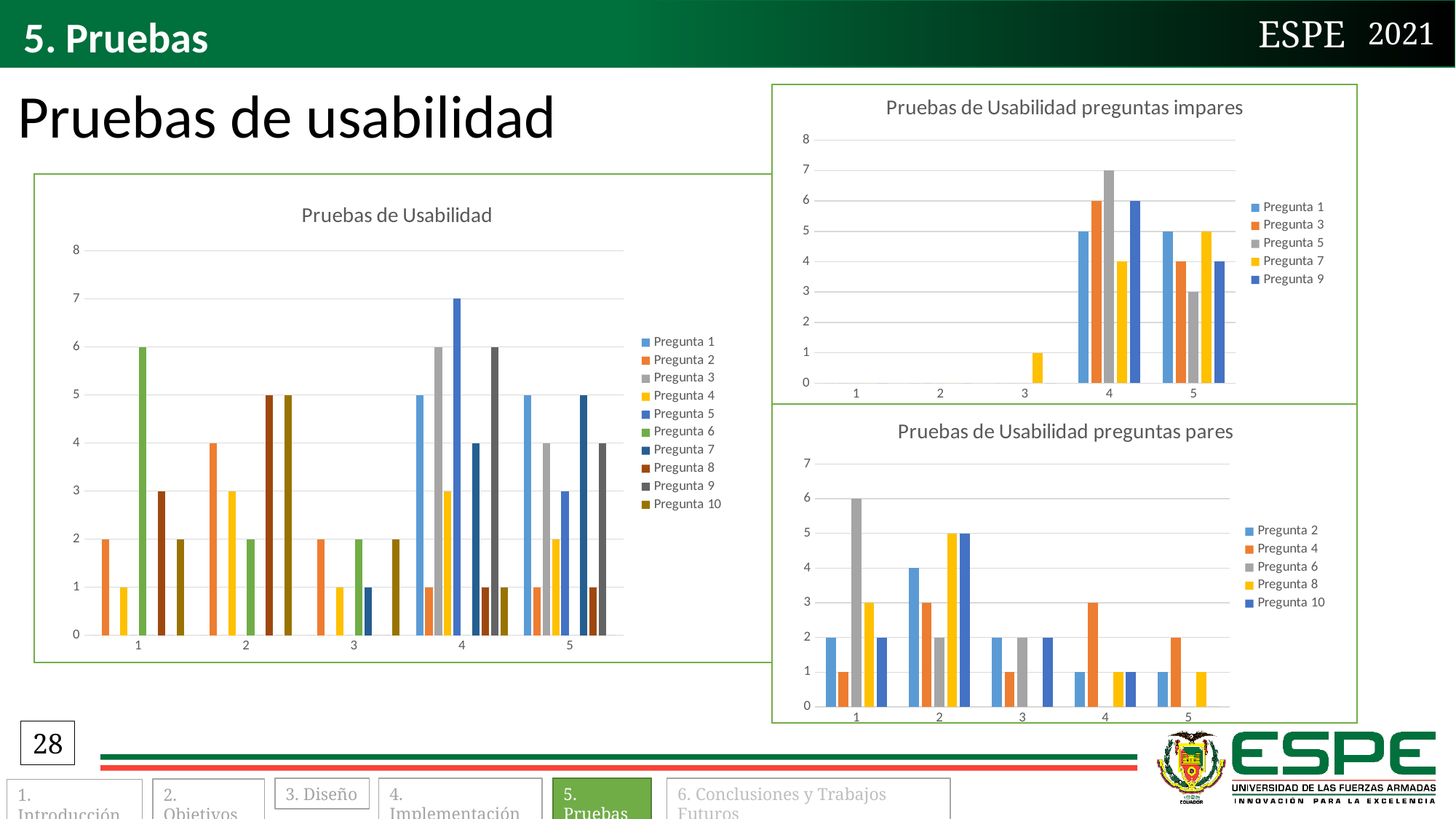
What kind of chart is the chart titled 'Pruebas de Usabilidad preguntas pares'? bar chart In the chart titled 'Pruebas de Usabilidad preguntas pares', is the value of Pregunta 4 at category 4 larger than the value of Pregunta 2 at category 4? Yes In the chart titled 'Pruebas de Usabilidad preguntas pares', what is the difference between Pregunta 6 and Pregunta 4 at category 1? 5 In the chart titled 'Pruebas de Usabilidad preguntas impares', what is the value of Pregunta 7 at category 3? 1 In the chart titled 'Pruebas de Usabilidad preguntas impares', how many series does the legend list? 5 In the chart titled 'Pruebas de Usabilidad', what is the value of Pregunta 6 at category 1? 6 In the chart titled 'Pruebas de Usabilidad preguntas impares', which series has the highest value at category 4? Pregunta 5 In the chart titled 'Pruebas de Usabilidad', how many series does the legend list? 10 In the chart titled 'Pruebas de Usabilidad preguntas pares', what is the value of Pregunta 6 at category 1? 6 In the chart titled 'Pruebas de Usabilidad preguntas pares', which series has the lowest value at category 2? Pregunta 6 How many categories are shown on the x axis of the chart titled 'Pruebas de Usabilidad'? 5 In the chart titled 'Pruebas de Usabilidad preguntas impares', what is the value of Pregunta 5 at category 4? 7